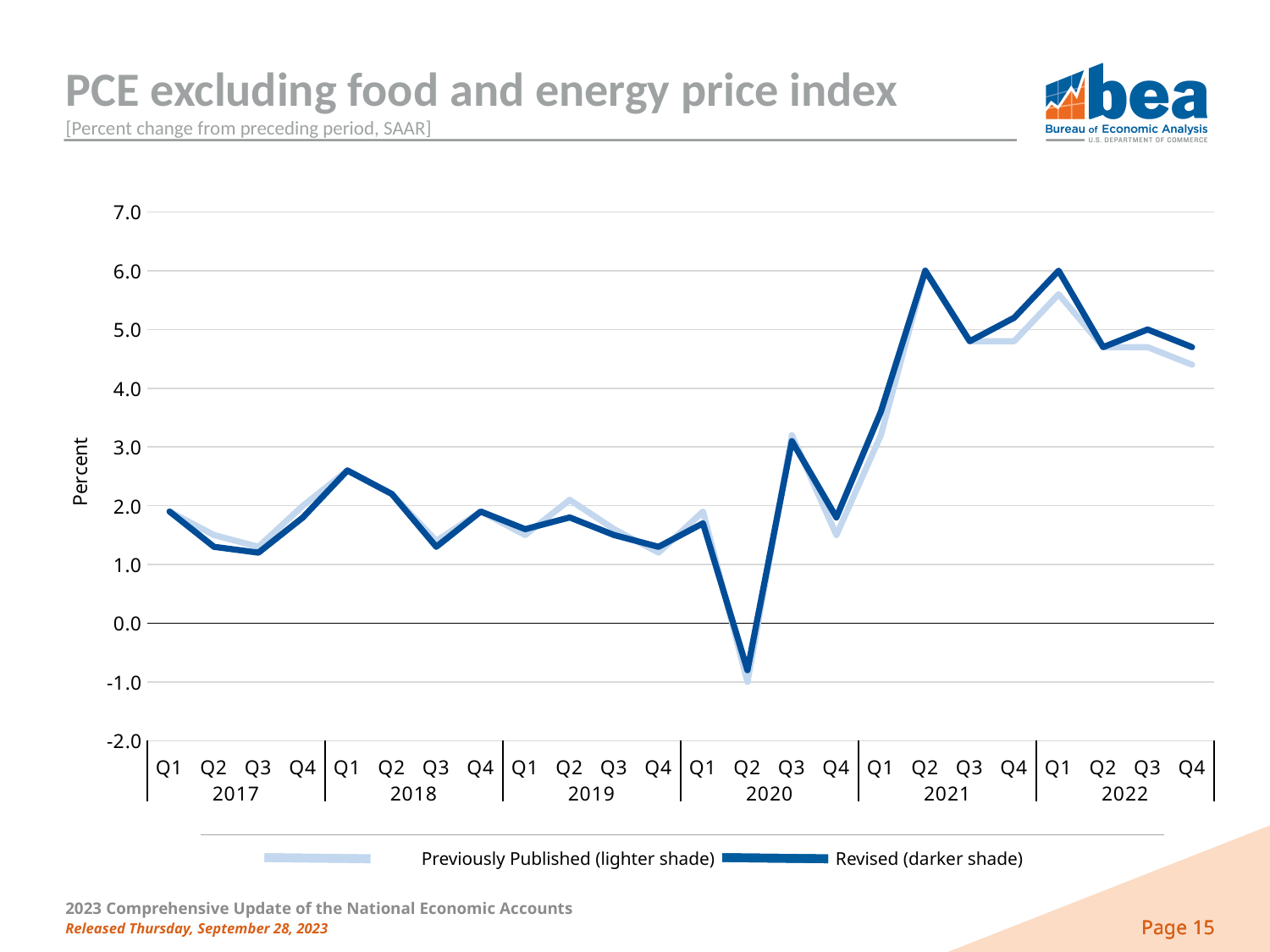
Which series is drawn in the darker shade according to the legend? Revised What kind of chart is shown on the slide? Line chart Is the Revised value for Q4 2022 greater or less than 5.0? less Is the Revised value for Q1 2021 greater or less than 5.0? less In which quarter does the Revised series reach its lowest value? Q2 2020 How many series does the legend list? 2 Is the Revised value for Q2 2020 greater or less than 0.0? less How many quarterly points are plotted along the x axis? 24 Does the Revised series rise or fall from Q2 2020 to Q1 2021? Rise Which is larger for the Revised series: the value for Q1 2021 or the value for Q1 2017? Q1 2021 What is the title of the chart? PCE excluding food and energy price index